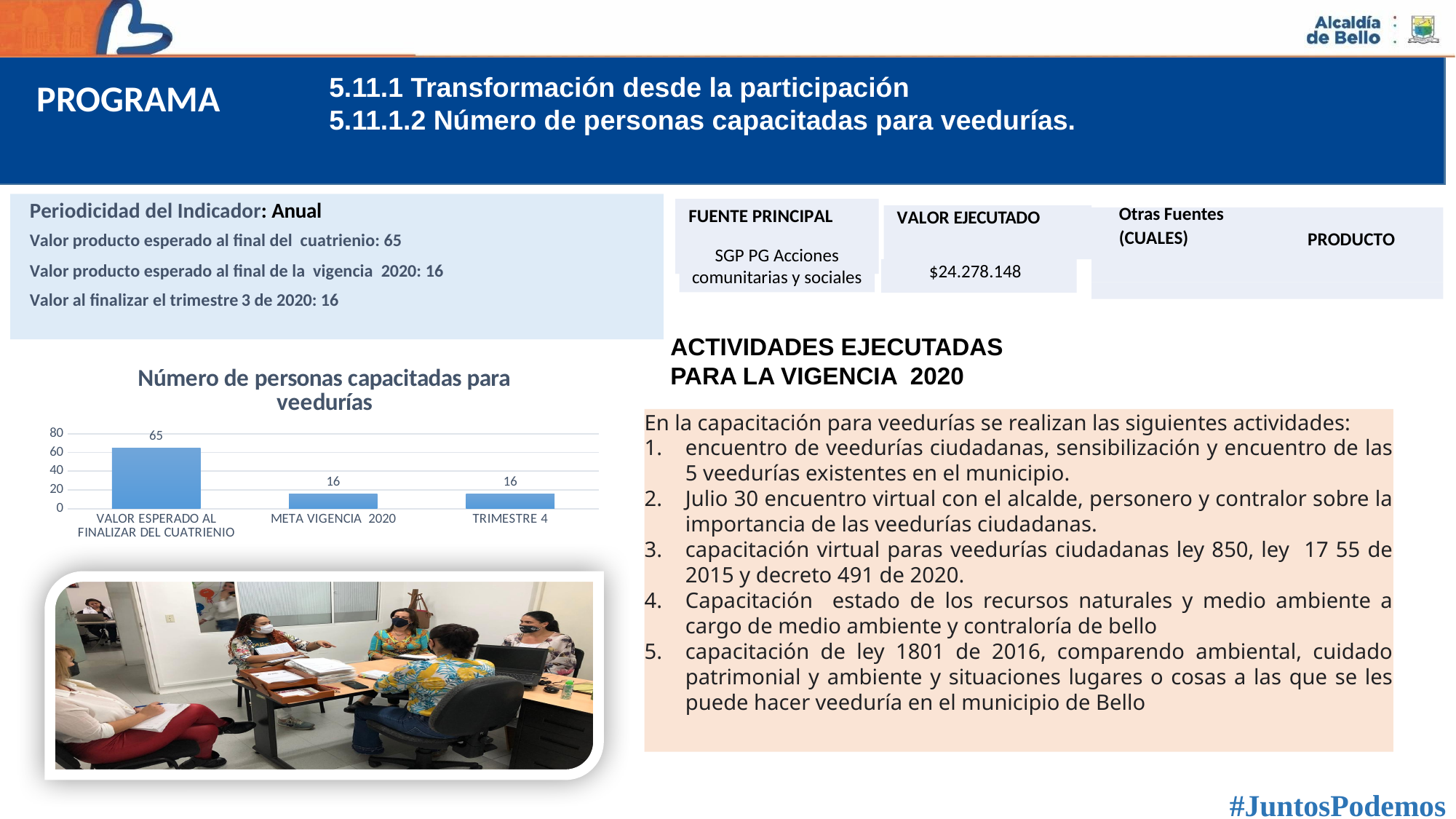
What is the value for META VIGENCIA 2020 in the chart? 16 Which category has the highest value in the chart? VALOR ESPERADO AL FINALIZAR DEL CUATRIENIO What is the highest value shown on the vertical axis of the chart? 80 How many categories are shown in the chart? 3 What kind of chart is shown on the slide? bar chart Is the value for META VIGENCIA 2020 greater or less than 20? less What is the value for VALOR ESPERADO AL FINALIZAR DEL CUATRIENIO in the chart? 65 What is the title of the chart? Número de personas capacitadas para veedurías Is the value for VALOR ESPERADO AL FINALIZAR DEL CUATRIENIO greater or less than 60? greater What is the value for TRIMESTRE 4 in the chart? 16 What is the difference between the value for VALOR ESPERADO AL FINALIZAR DEL CUATRIENIO and the value for META VIGENCIA 2020? 49 Which is larger, the value for VALOR ESPERADO AL FINALIZAR DEL CUATRIENIO or the value for TRIMESTRE 4? VALOR ESPERADO AL FINALIZAR DEL CUATRIENIO